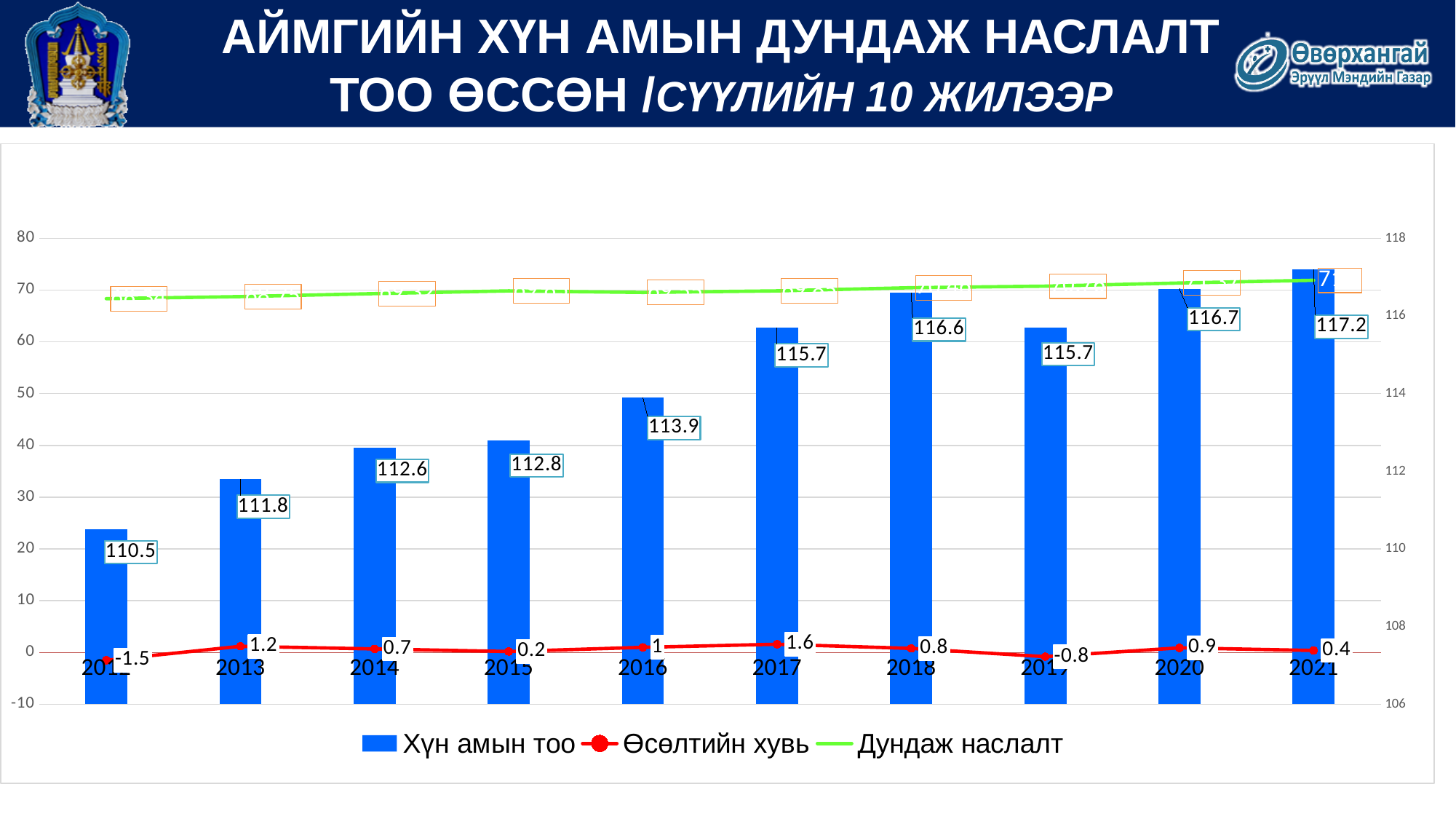
What is the data label for Хүн амын тоо in 2012? 110.5 How many series does the legend list? 3 In which year is the Хүн амын тоо bar the highest? 2021 What is the value of Өсөлтийн хувь in 2012? -1.5 Which year has the larger Хүн амын тоо value, 2015 or 2016? 2016 How many years are shown on the x axis? 10 What is the difference between the Хүн амын тоо labels for 2021 and 2012? 6.7 In which year is Өсөлтийн хувь lowest? 2012 What is the data label for Хүн амын тоо in 2021? 117.2 What kind of chart is shown on the slide? A combined bar and line chart In which year is Өсөлтийн хувь highest? 2017 What is the value of Өсөлтийн хувь in 2017? 1.6